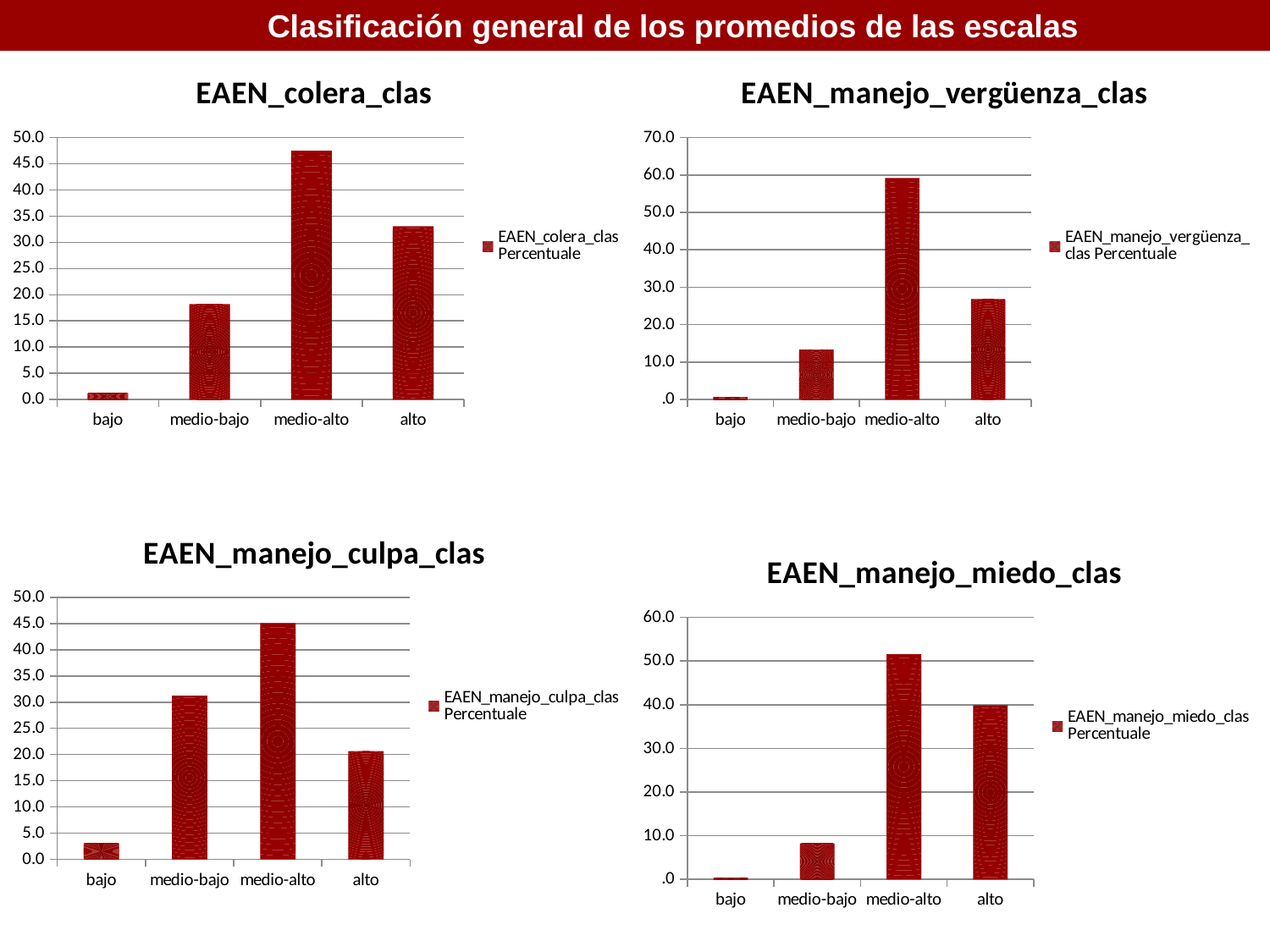
In the EAEN_manejo_vergüenza_clas chart, is the value for medio-bajo greater or less than 20.0? less In the EAEN_colera_clas chart, is the value for alto greater or less than 30.0? greater In the EAEN_colera_clas chart, which category has the lowest value? bajo How many categories are shown on the x axis of the EAEN_manejo_miedo_clas chart? 4 In the EAEN_manejo_vergüenza_clas chart, which is larger, the value for medio-bajo or the value for alto? alto In the EAEN_manejo_miedo_clas chart, which category has the lowest value? bajo In the EAEN_manejo_miedo_clas chart, is the value for medio-alto greater or less than 50.0? greater In the EAEN_colera_clas chart, which category has the highest value? medio-alto In the EAEN_manejo_culpa_clas chart, which category has the highest value? medio-alto In the EAEN_manejo_culpa_clas chart, which is larger, the value for medio-bajo or the value for alto? medio-bajo In the EAEN_manejo_vergüenza_clas chart, which category has the highest value? medio-alto